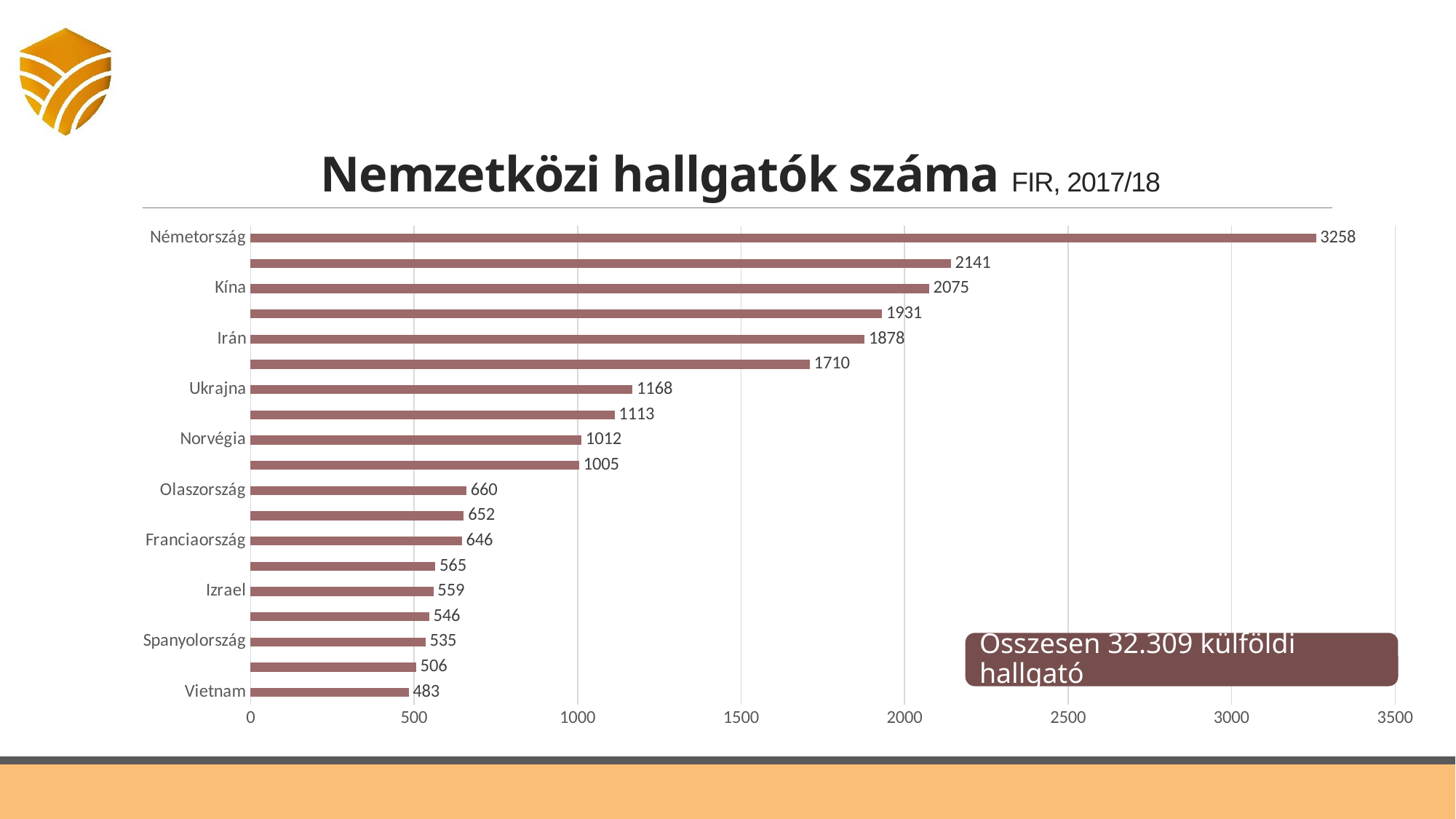
What is the value for Vietnam? 483 Which country has the highest value? Németország Which labelled country has the lowest value? Vietnam What is the value for Kína? 2075 What is the difference between the values for Németország and Kína? 1183 Is the value for Spanyolország greater or less than 1000? less What is the value for Németország? 3258 What type of chart is shown on the slide? bar chart Which has a larger value, Ukrajna or Olaszország? Ukrajna What is the value for Norvégia? 1012 What is the title of the chart? Nemzetközi hallgatók száma What is the value for Irán? 1878